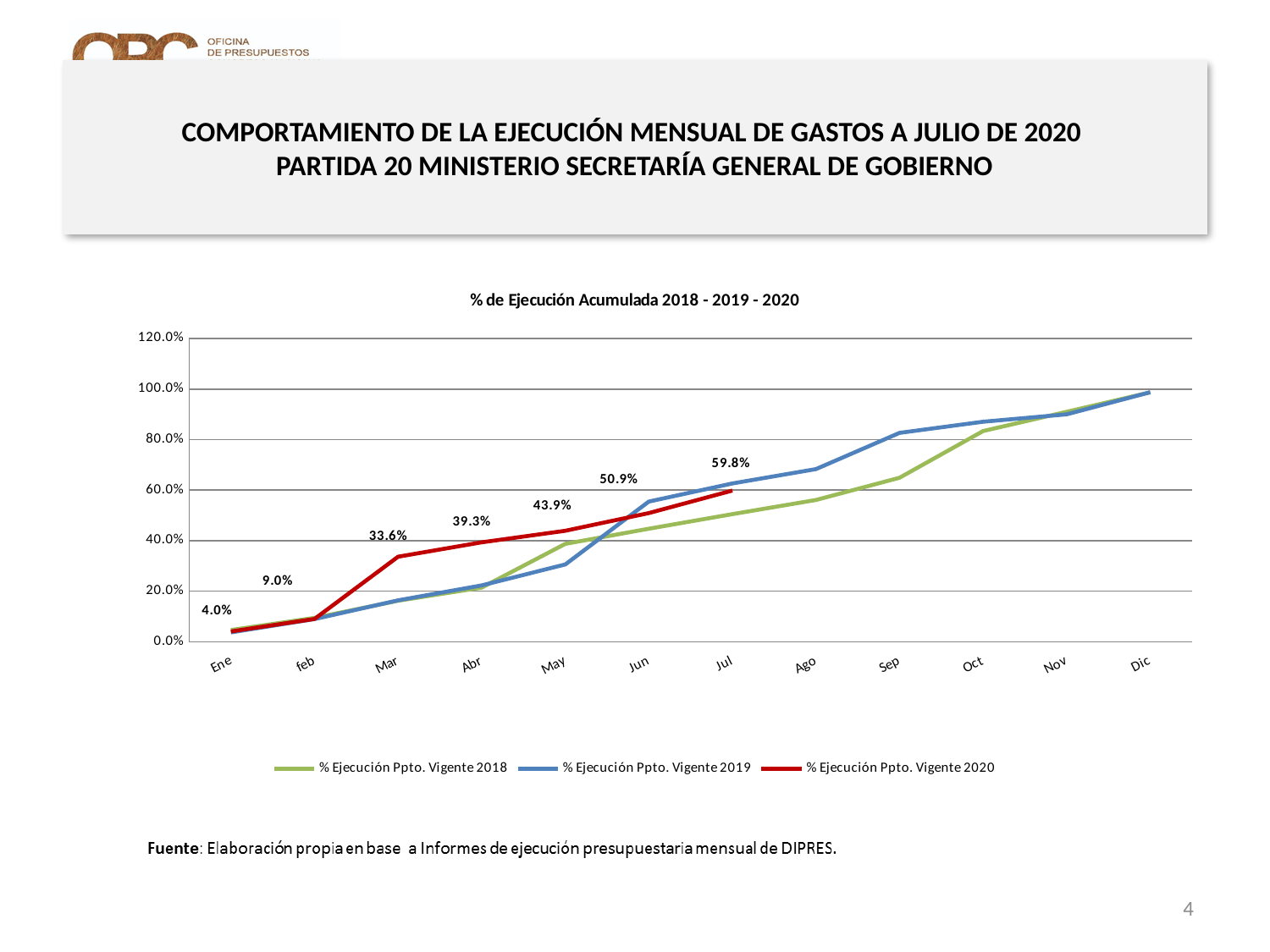
What is the title of the chart? % de Ejecución Acumulada 2018 - 2019 - 2020 What kind of chart is shown on the slide? Line chart What is the value of % Ejecución Ppto. Vigente 2020 in Mar? 33.6% Is the value for % Ejecución Ppto. Vigente 2018 in Sep greater or less than 80.0%? less In May, which series has the larger value: % Ejecución Ppto. Vigente 2020 or % Ejecución Ppto. Vigente 2019? % Ejecución Ppto. Vigente 2020 By how much did % Ejecución Ppto. Vigente 2020 increase from Jun to Jul? 8.9% How many months are shown on the x axis? 12 What is the value of % Ejecución Ppto. Vigente 2020 in Ene? 4.0% What is the value of % Ejecución Ppto. Vigente 2020 in Jul? 59.8% How many series does the legend list? 3 Does the % Ejecución Ppto. Vigente 2020 line rise or fall from Ene to Jul? Rises What is the difference between the 2020 values for Mar and Feb? 24.6%